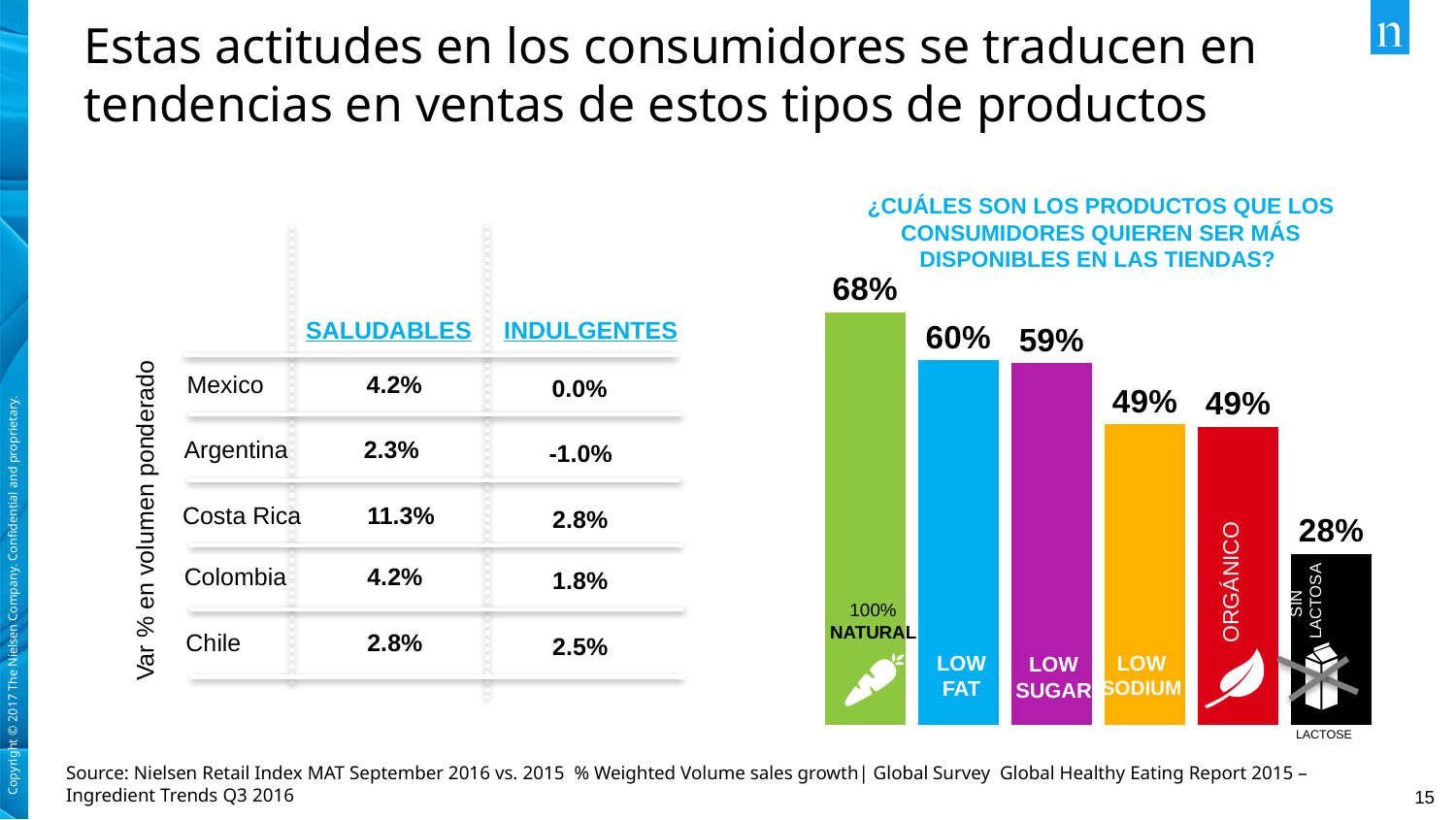
In the bar chart on the right, which category has the highest value? 100% NATURAL In the bar chart on the right, what is the value for LOW FAT? 60% In the bar chart on the right, what is the difference between the values for LOW FAT and LOW SODIUM? 11% In the bar chart on the right, what is the value for 100% NATURAL? 68% In the bar chart on the right, which is larger, the value for LOW FAT or the value for ORGÁNICO? LOW FAT In the bar chart on the right, what is the value for SIN LACTOSA? 28% How many bars are shown in the bar chart on the right? 6 In the bar chart on the right, what is the difference between the values for 100% NATURAL and SIN LACTOSA? 40% In the bar chart on the right, which category has the lowest value? SIN LACTOSA In the bar chart on the right, do the values rise or fall from left to right? Fall In the bar chart on the right, what is the value for LOW SUGAR? 59% What kind of chart is shown on the right side of the slide? Bar chart